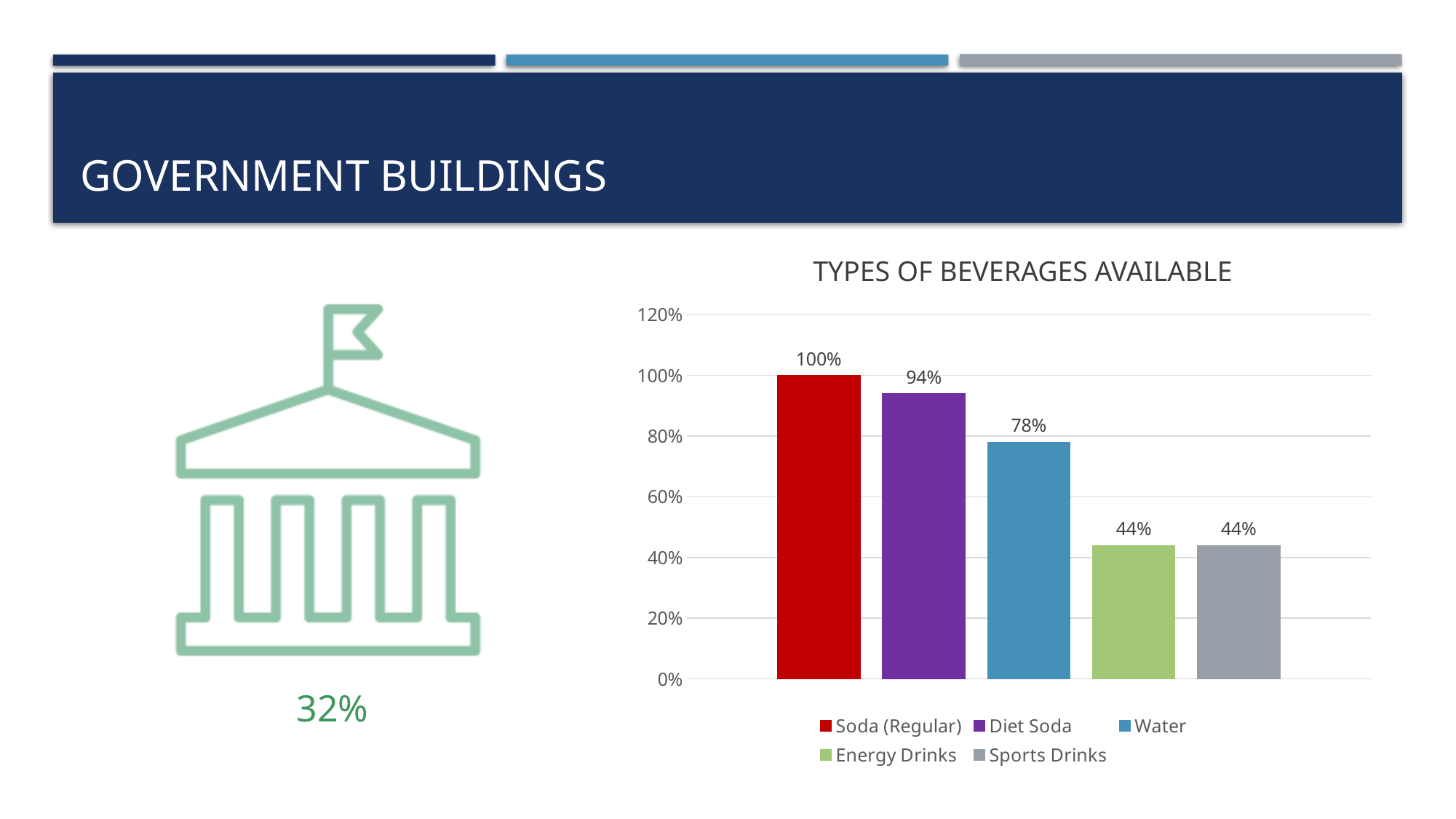
What is the value for Water in the Types of Beverages Available chart? 78% What is the difference between the values for Diet Soda and Sports Drinks? 50% What kind of chart is shown on the slide? bar chart What is the title of the chart? Types of Beverages Available What is the value for Energy Drinks? 44% What is the difference between the values for Soda (Regular) and Water? 22% Which beverage type has the highest value? Soda (Regular) Which is larger, the value for Diet Soda or the value for Water? Diet Soda How many beverage types are shown in the chart? 5 What is the value for Diet Soda? 94% Is the value for Sports Drinks greater or less than 60%? less How many entries does the legend list? 5